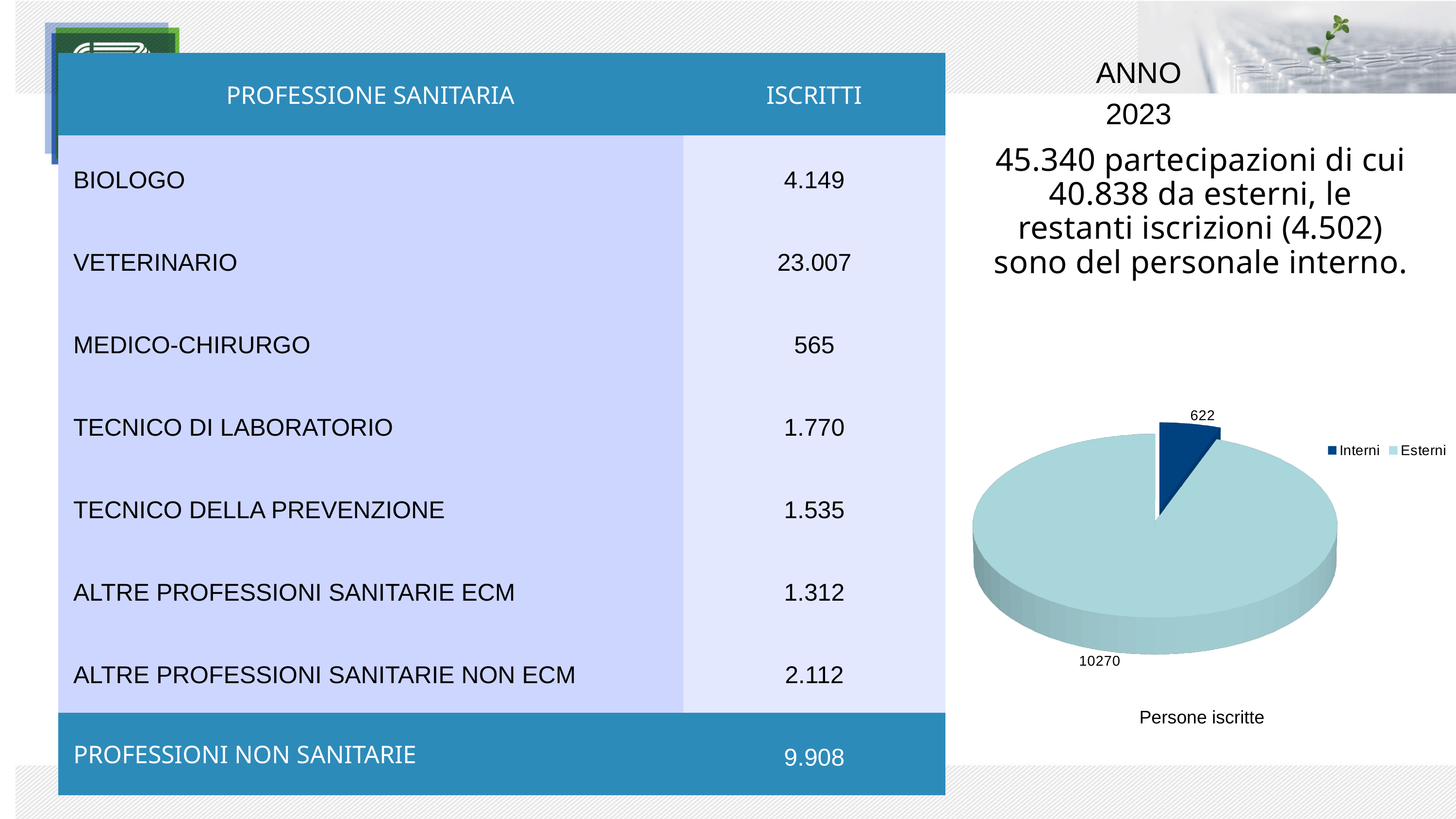
In the pie chart, what is the difference between the Esterni value and the Interni value? 9648 In the pie chart, which colour represents Interni? Dark blue Which slice of the pie chart is the largest? Esterni In the pie chart, which is larger: Interni or Esterni? Esterni In the pie chart, what is the value for Interni? 622 In the pie chart, what is the value for Esterni? 10270 Which slice of the pie chart is the smallest? Interni What is the title of the pie chart? Persone iscritte What is the total of the two values shown in the pie chart? 10892 How many entries does the legend of the pie chart list? 2 How many slices does the pie chart have? 2 What kind of chart is shown on the right of the slide? Pie chart